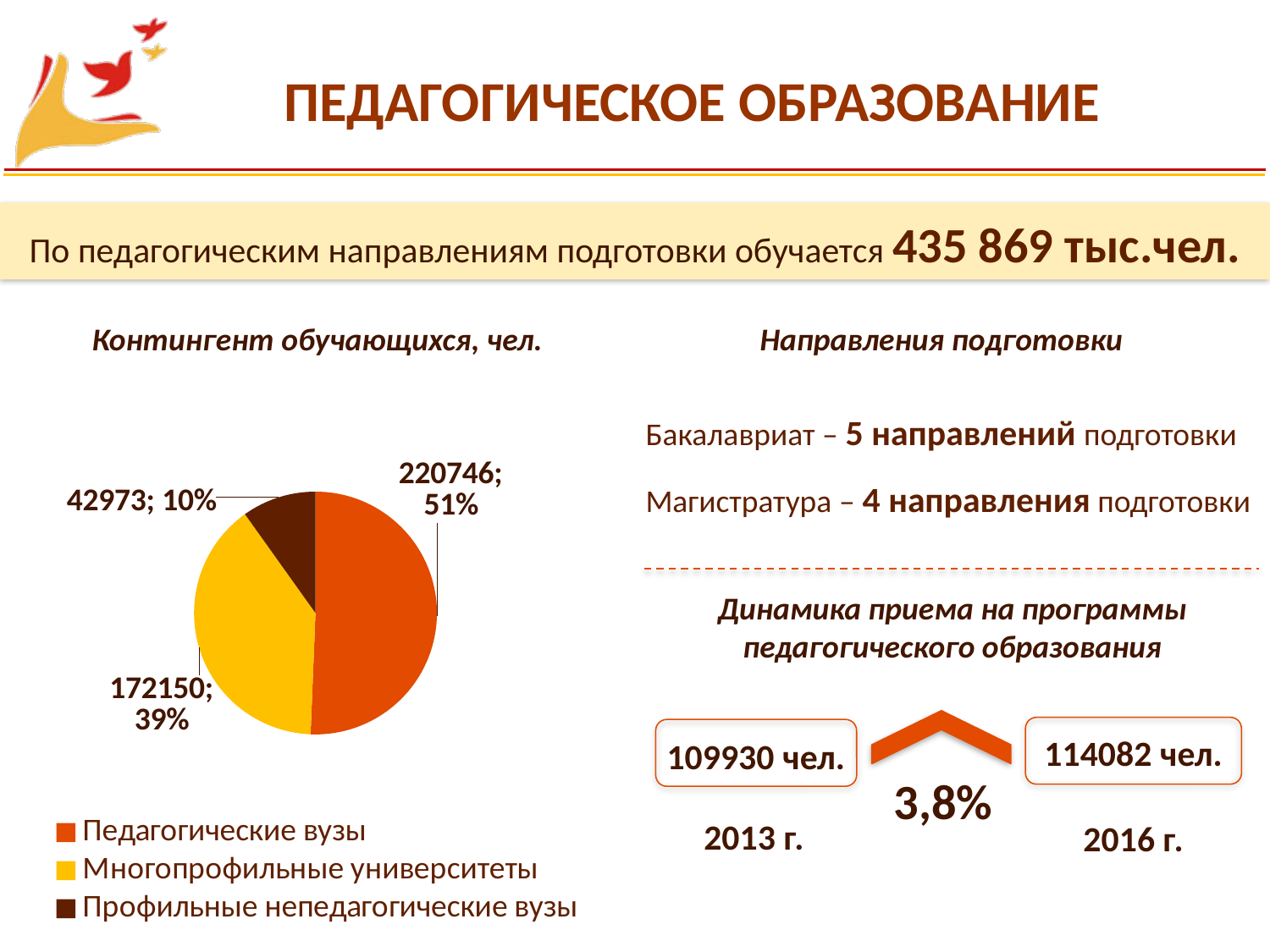
What share of the pie does "Профильные непедагогические вузы" take? 10% How many slices does the pie chart "Контингент обучающихся, чел." have? 3 Which category has the largest slice in the pie chart? Педагогические вузы Which category has the smallest slice in the pie chart? Профильные непедагогические вузы What kind of chart is shown under the title "Контингент обучающихся, чел."? pie chart What is the difference between the values for "Педагогические вузы" and "Многопрофильные университеты" in the pie chart? 48596 What share of the pie does "Педагогические вузы" take? 51% What is the value for "Многопрофильные университеты" in the pie chart? 172150 What is the value for "Педагогические вузы" in the pie chart? 220746 What is the value for "Профильные непедагогические вузы" in the pie chart? 42973 Which colour represents "Многопрофильные университеты" in the pie chart? yellow How many entries does the legend of the pie chart list? 3